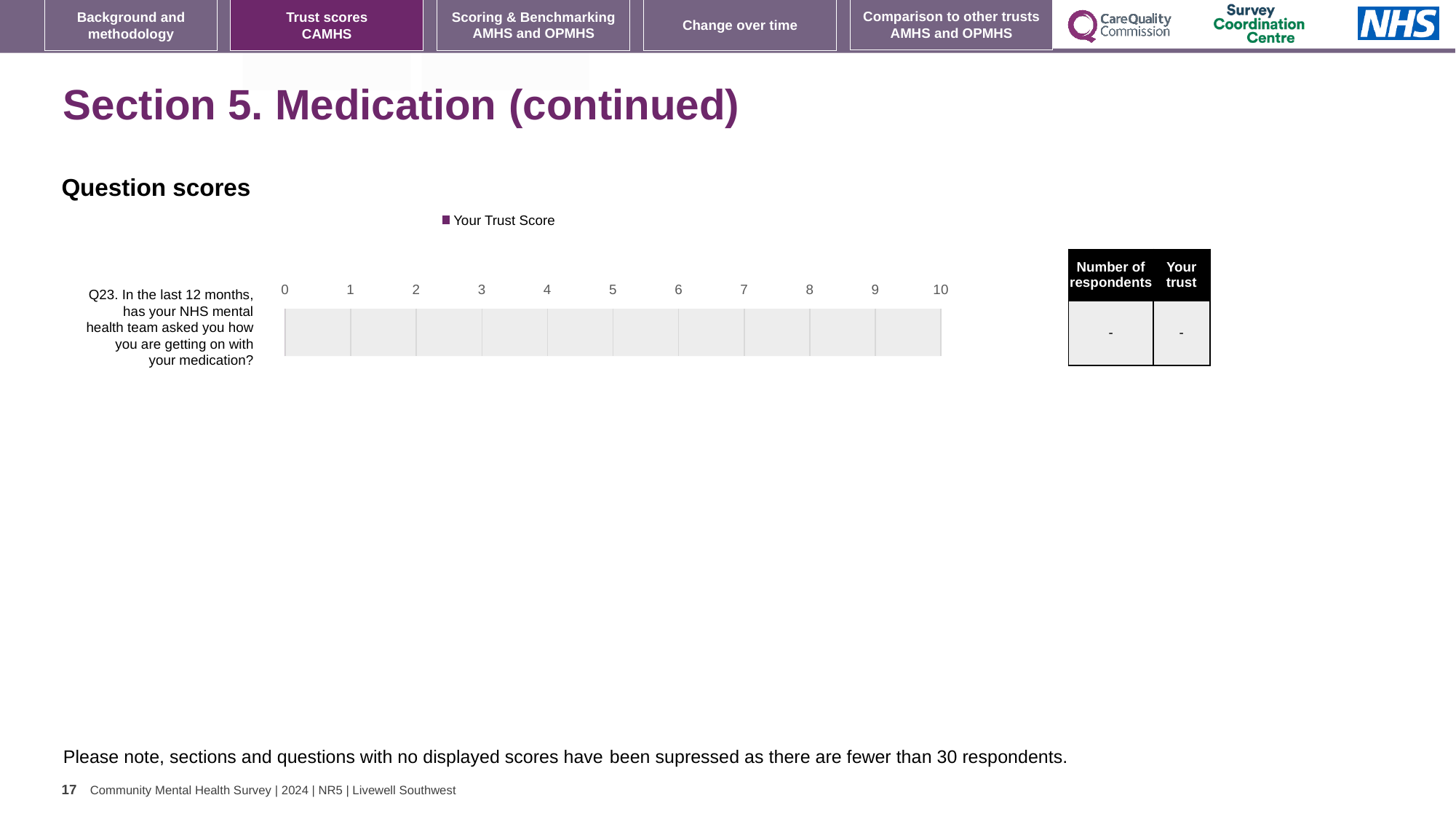
Which question is plotted on the chart? Q23. In the last 12 months, has your NHS mental health team asked you how you are getting on with your medication? What kind of chart is shown under "Question scores"? bar chart How many series does the chart legend list? 1 What is the name of the series listed in the chart legend? Your Trust Score What is the highest value shown on the chart's x axis? 10 How many questions (categories) are shown on the chart? 1